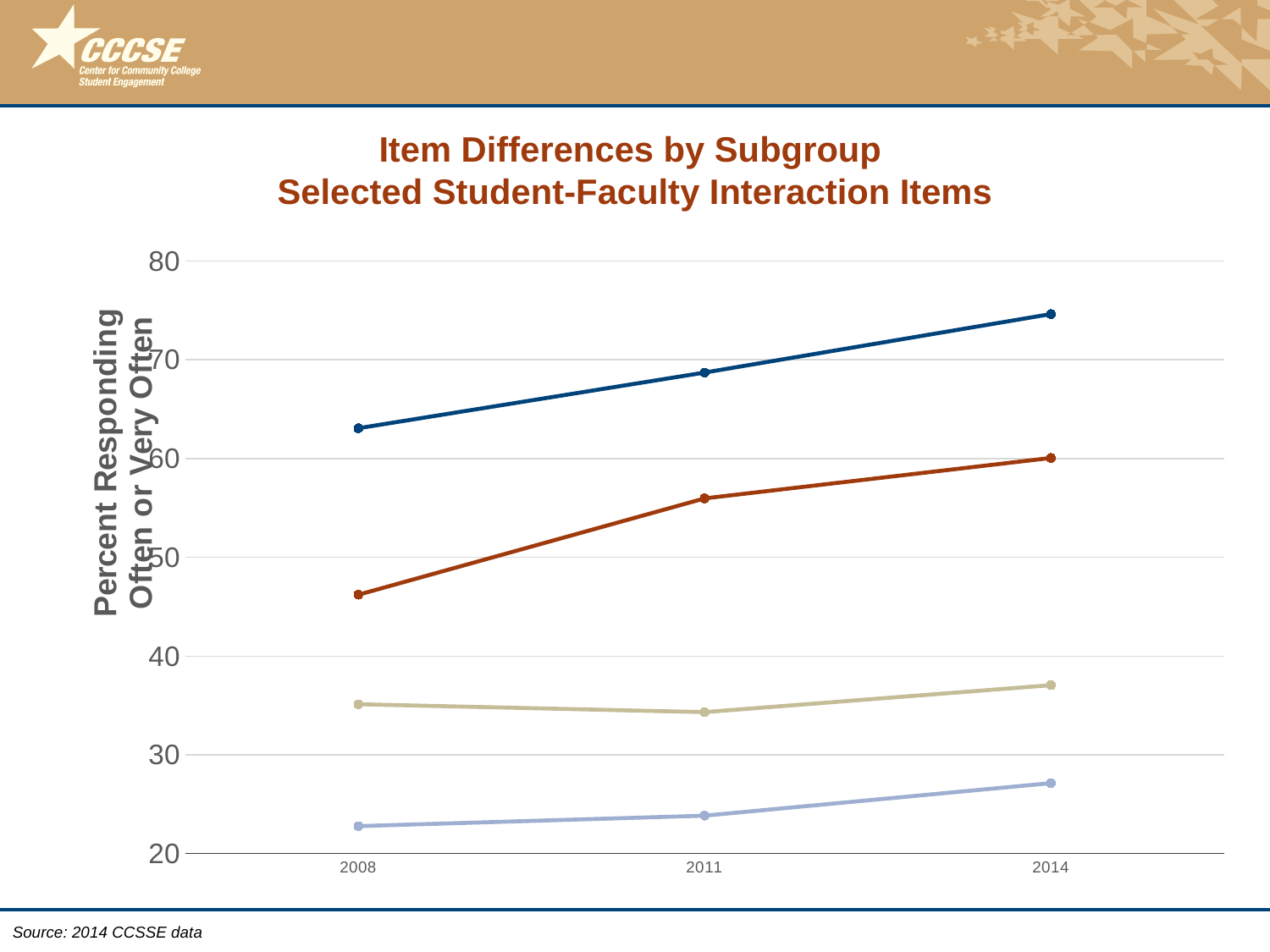
How many lines are plotted on the chart? 4 Is the value of the dark blue line in 2014 greater or less than 70? greater What kind of chart is shown on the slide? Line chart Is the value of the light blue line in 2014 greater or less than 30? less How many years are shown on the x axis of the chart? 3 Does the dark blue line rise or fall from 2008 to 2014? Rises Is the value of the dark blue line in 2008 greater or less than 60? greater Does the orange line rise or fall from 2008 to 2014? Rises Which line has the higher value in 2014, the dark blue line or the orange line? The dark blue line What is the label on the y axis of the chart? Percent Responding Often or Very Often